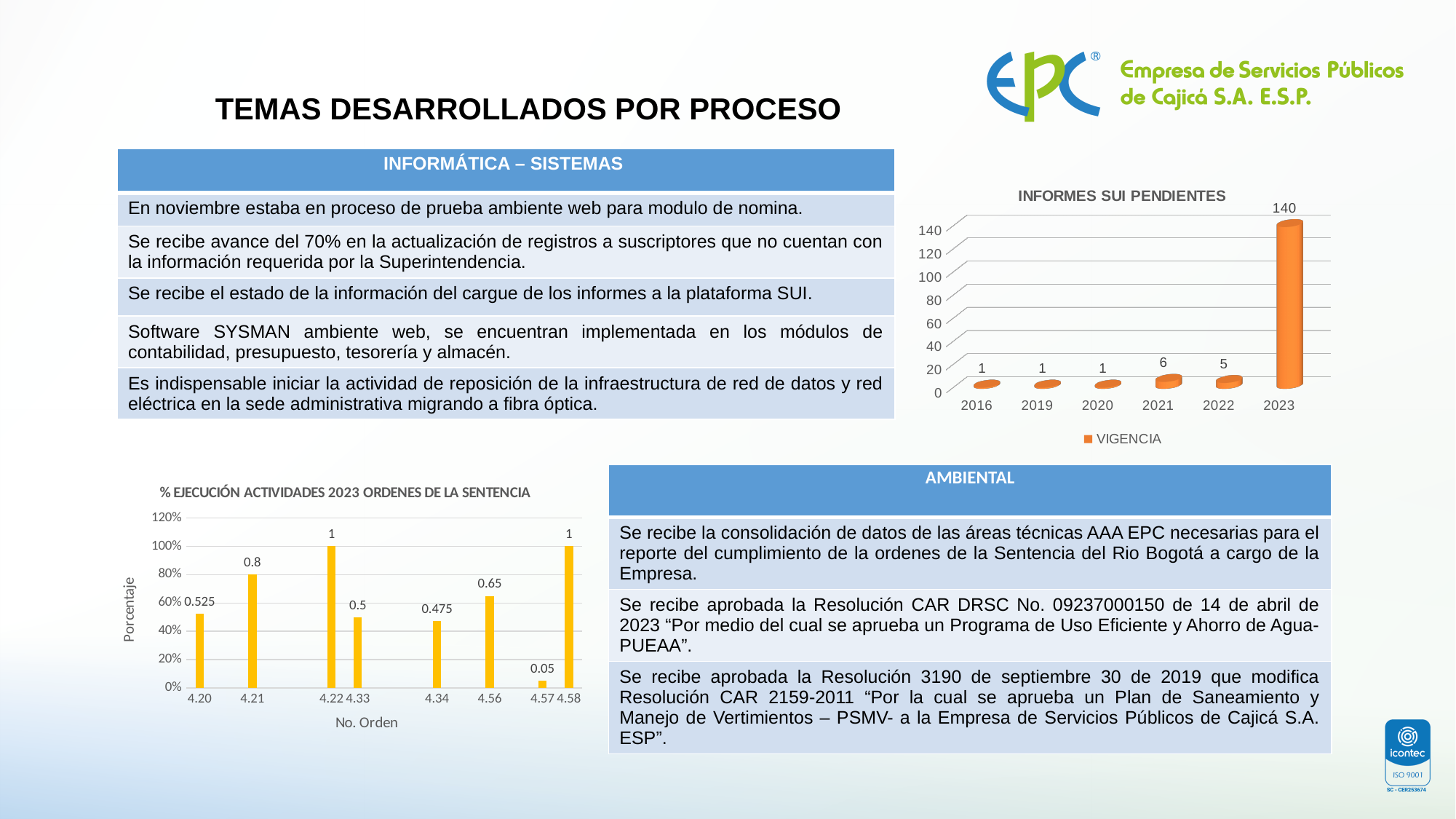
In the '% EJECUCIÓN ACTIVIDADES 2023 ORDENES DE LA SENTENCIA' chart, what is the value for order 4.21? 0.8 In the 'INFORMES SUI PENDIENTES' chart, what is the value for 2021? 6 What kind of chart is the '% EJECUCIÓN ACTIVIDADES 2023 ORDENES DE LA SENTENCIA' chart? Bar chart In the '% EJECUCIÓN ACTIVIDADES 2023 ORDENES DE LA SENTENCIA' chart, which is larger, the value for 4.20 or the value for 4.56? 4.56 In the 'INFORMES SUI PENDIENTES' chart, what is the difference between the values for 2021 and 2022? 1 In the '% EJECUCIÓN ACTIVIDADES 2023 ORDENES DE LA SENTENCIA' chart, which order has the lowest value? 4.57 In the 'INFORMES SUI PENDIENTES' chart, what is the value for 2023? 140 In the 'INFORMES SUI PENDIENTES' chart, which year has the highest value? 2023 In the 'INFORMES SUI PENDIENTES' chart, what series name does the legend show? VIGENCIA In the '% EJECUCIÓN ACTIVIDADES 2023 ORDENES DE LA SENTENCIA' chart, what is the value for order 4.57? 0.05 In the 'INFORMES SUI PENDIENTES' chart, how many years are shown on the x axis? 6 In the '% EJECUCIÓN ACTIVIDADES 2023 ORDENES DE LA SENTENCIA' chart, how many orders are shown on the x axis? 8